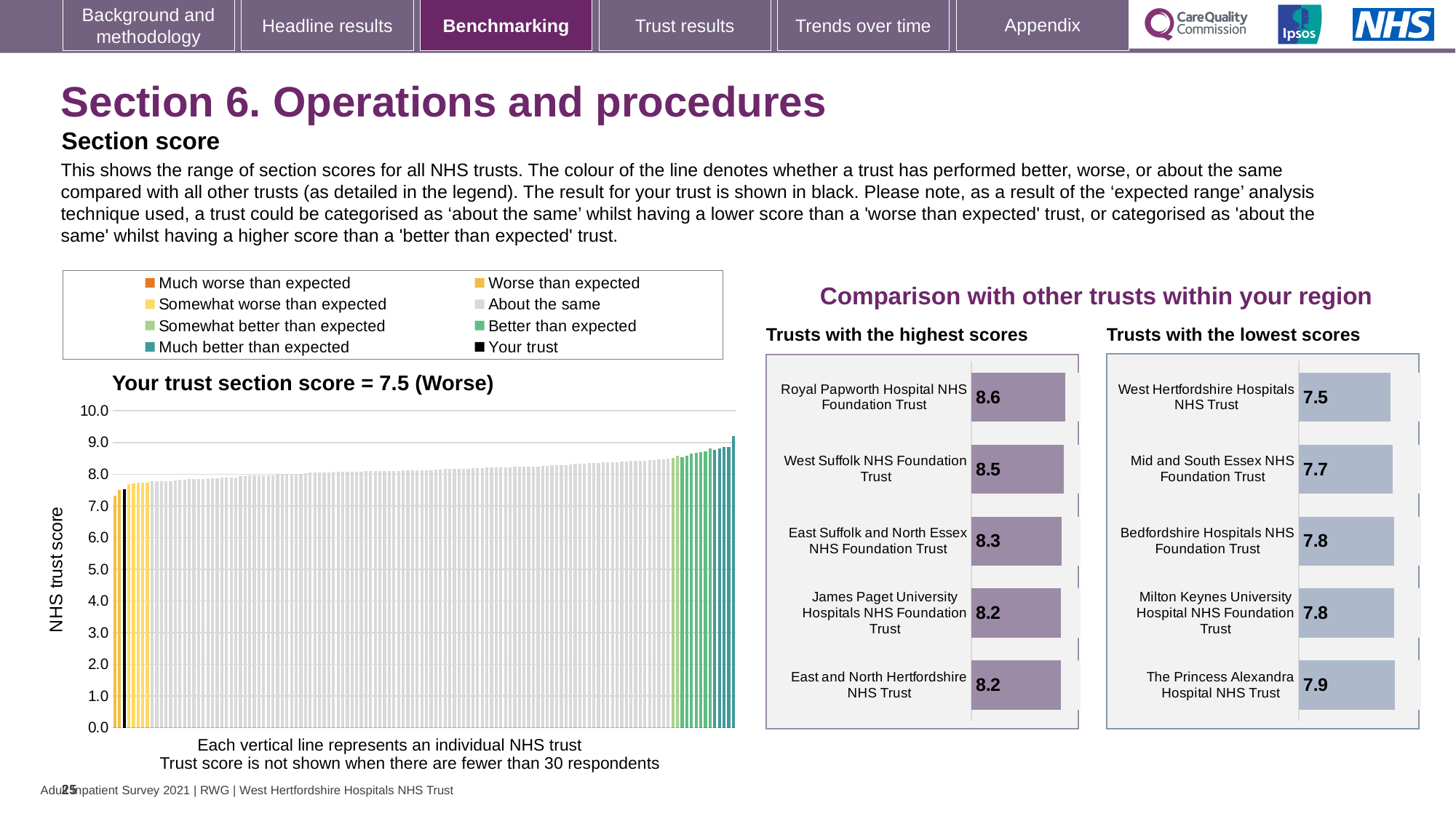
On the 'Trusts with the highest scores' chart, how many trusts are shown? 5 On the 'Your trust section score' chart, what is the label on the vertical axis? NHS trust score On the 'Trusts with the lowest scores' chart, which trust has the lowest score? West Hertfordshire Hospitals NHS Trust On the 'Your trust section score' chart, do the trust scores rise or fall from left to right? rise On the 'Your trust section score' chart, what is the section score for your trust? 7.5 On the 'Trusts with the lowest scores' chart, what is the score for Mid and South Essex NHS Foundation Trust? 7.7 On the 'Trusts with the lowest scores' chart, which has the larger score, The Princess Alexandra Hospital NHS Trust or West Hertfordshire Hospitals NHS Trust? The Princess Alexandra Hospital NHS Trust On the 'Trusts with the highest scores' chart, what is the score for Royal Papworth Hospital NHS Foundation Trust? 8.6 On the 'Trusts with the highest scores' chart, what is the difference between the scores of Royal Papworth Hospital NHS Foundation Trust and East and North Hertfordshire NHS Trust? 0.4 On the 'Trusts with the highest scores' chart, which trust has the highest score? Royal Papworth Hospital NHS Foundation Trust On the 'Your trust section score' chart, what kind of chart is shown? bar chart On the 'Your trust section score' chart, how many entries does the legend list? 8